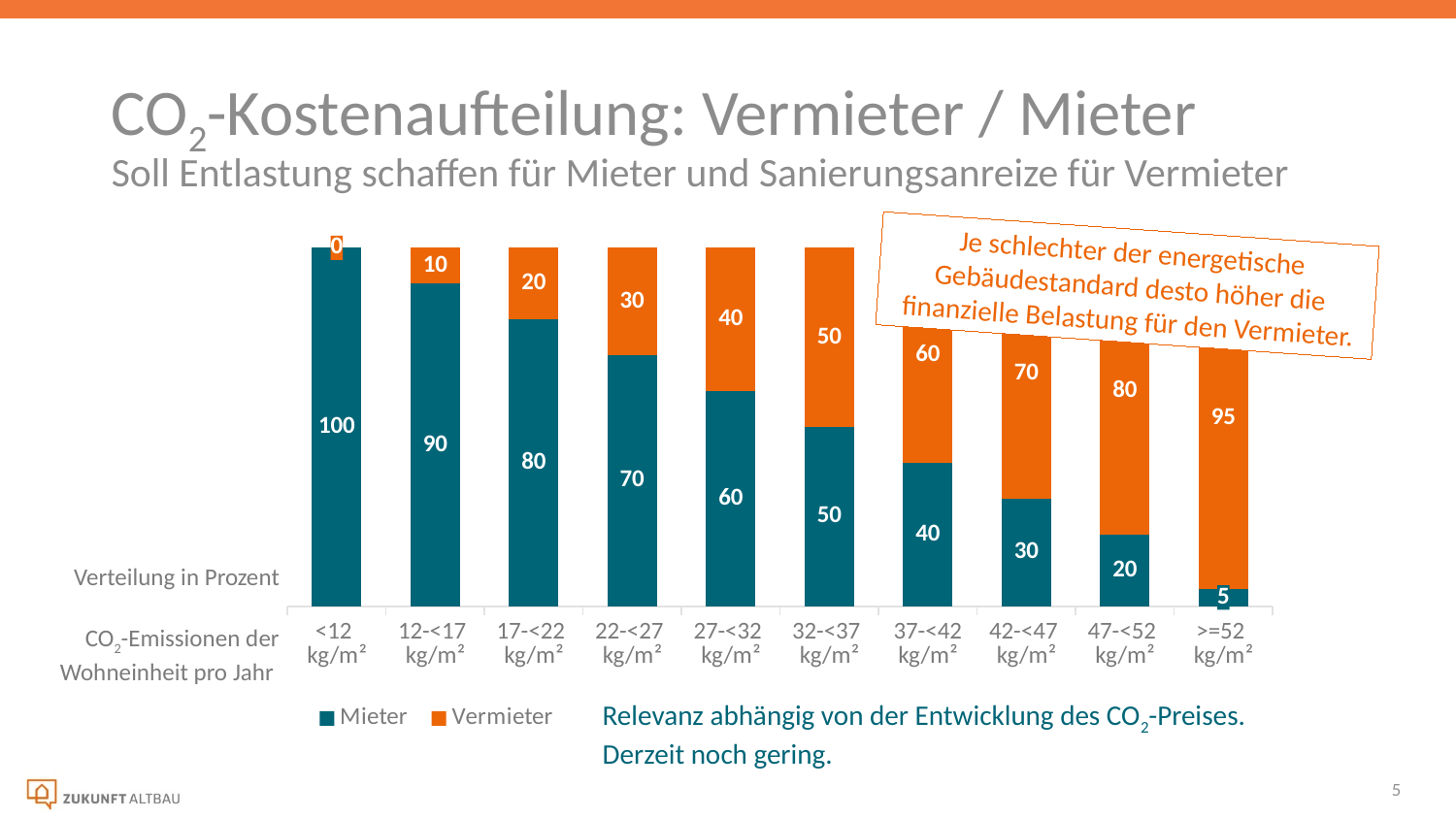
How many series does the legend list? 2 What is the Mieter value for the category >=52 kg/m²? 5 What is the difference between the Mieter and Vermieter values for the category 37-<42 kg/m²? 20 Which colour represents the Vermieter series in the chart? orange Which category has the lowest Mieter value? >=52 kg/m² How many emission categories are shown on the x axis? 10 What is the Vermieter value for the category 42-<47 kg/m²? 70 What is the Mieter value for the category 22-<27 kg/m²? 70 For the category 27-<32 kg/m², which is larger: the Mieter value or the Vermieter value? Mieter What kind of chart is shown on the slide? stacked bar chart Which category has the highest Vermieter value? >=52 kg/m² How do the Mieter values change as the emission categories increase along the x axis? They fall